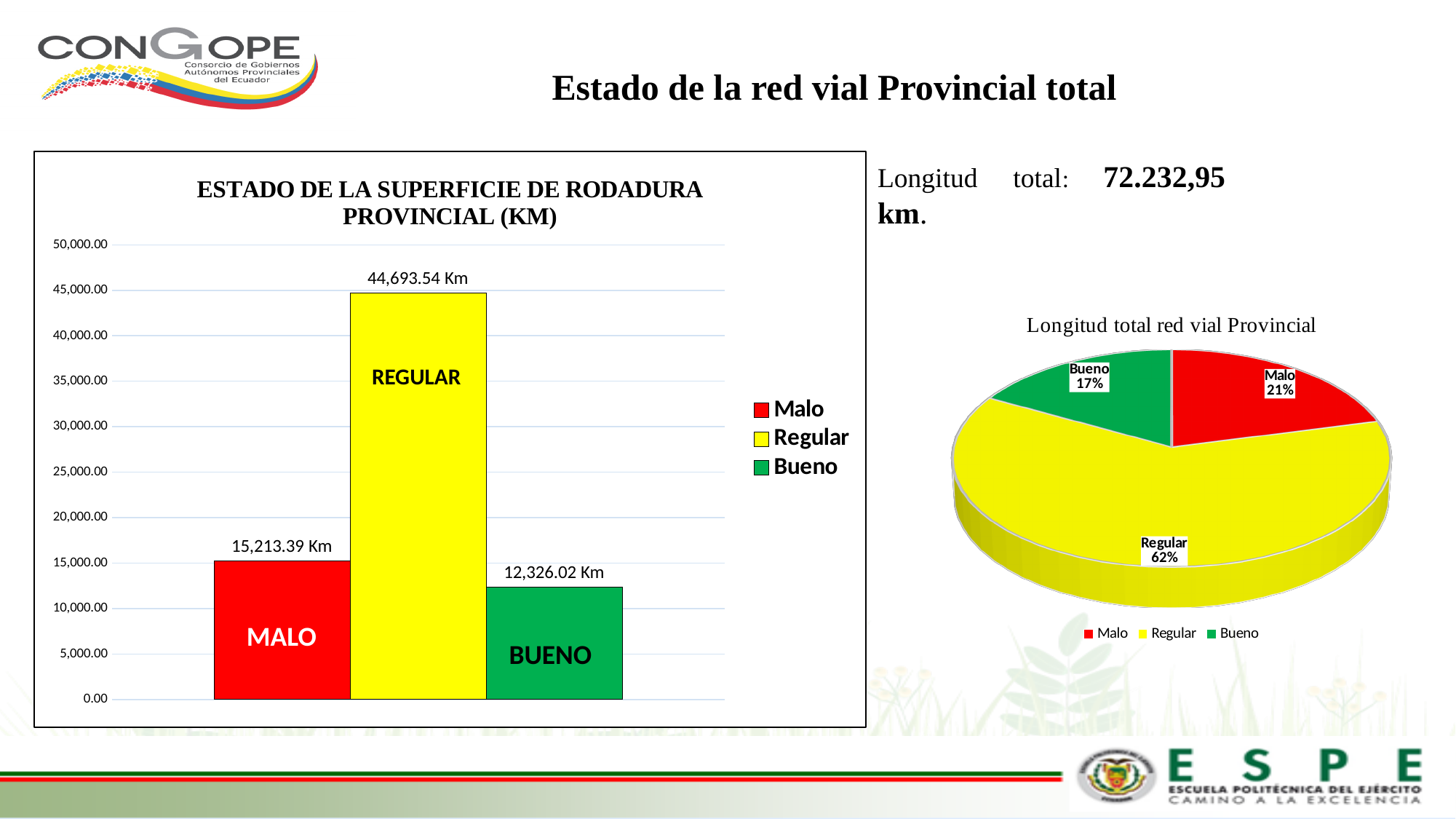
In the bar chart 'ESTADO DE LA SUPERFICIE DE RODADURA PROVINCIAL (KM)', what is the value for Bueno? 12,326.02 Km In the bar chart on the left, what is the difference between the Regular and Malo values? 29,480.15 Km In the bar chart on the left, which category has the lowest value? Bueno In the bar chart 'ESTADO DE LA SUPERFICIE DE RODADURA PROVINCIAL (KM)', what is the value for Regular? 44,693.54 Km What kind of chart is the chart on the left of the slide? Bar chart In the bar chart 'ESTADO DE LA SUPERFICIE DE RODADURA PROVINCIAL (KM)', what is the value for Malo? 15,213.39 Km In the bar chart on the left, which category has the highest value? Regular In the pie chart 'Longitud total red vial Provincial', which slice is the largest? Regular In the pie chart 'Longitud total red vial Provincial', what share does Bueno have? 17% In the bar chart on the left, which is larger, the value for Malo or the value for Bueno? Malo In the pie chart 'Longitud total red vial Provincial', what share does Regular have? 62% In the bar chart on the left, how many bars are plotted? 3